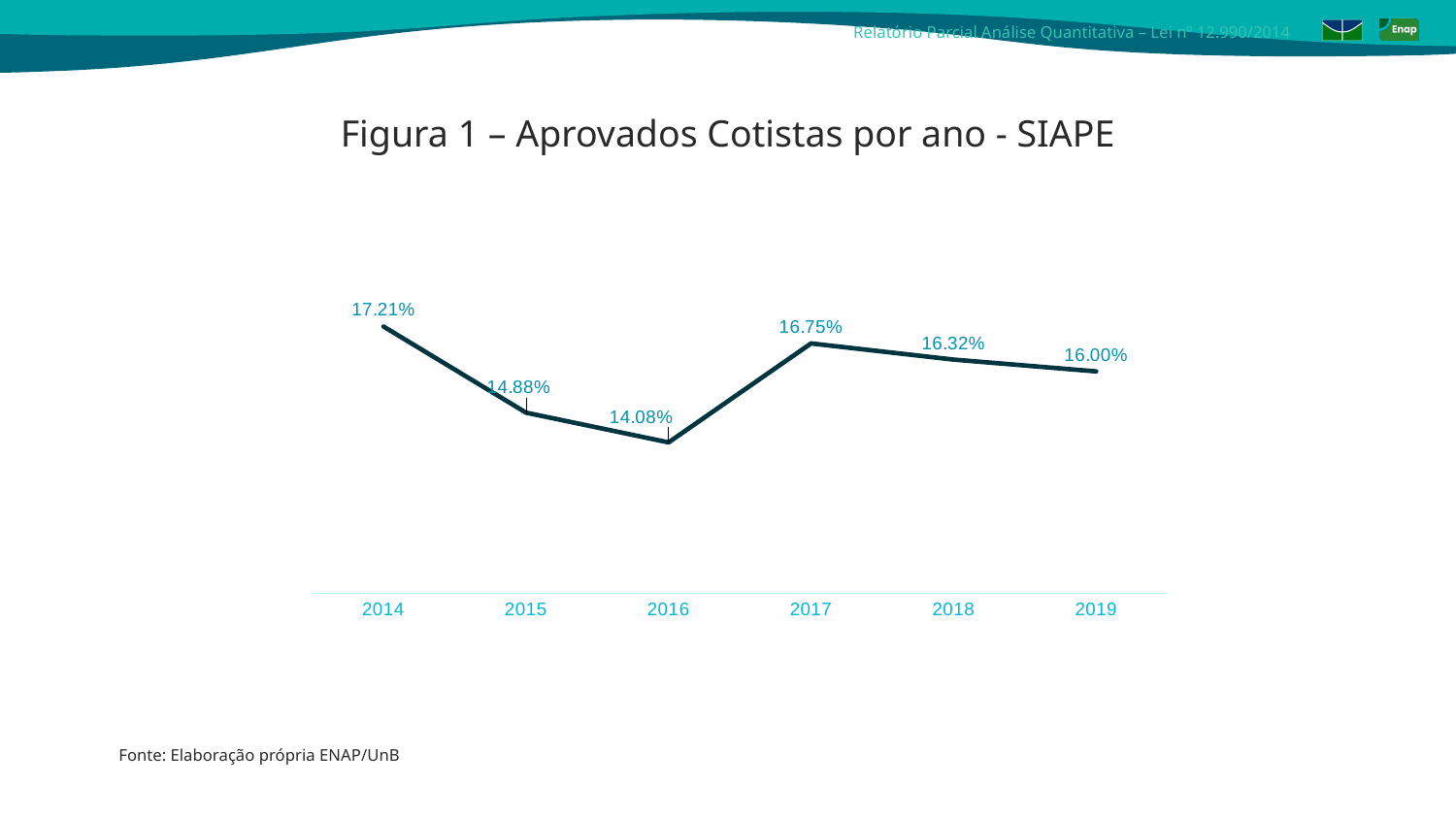
Which year has the lowest value? 2016 What is the value for 2016? 14.08% What is the value for 2019? 16.00% Do the values rise or fall from 2017 to 2019? fall What is the value for 2014? 17.21% What is the difference between the values for 2017 and 2018? 0.43% What is the difference between the values for 2014 and 2016? 3.13% Which year has the highest value? 2014 How many years are plotted on the chart? 6 What is the value for 2018? 16.32% What kind of chart is shown? line chart Which is larger, the value for 2015 or the value for 2017? 2017